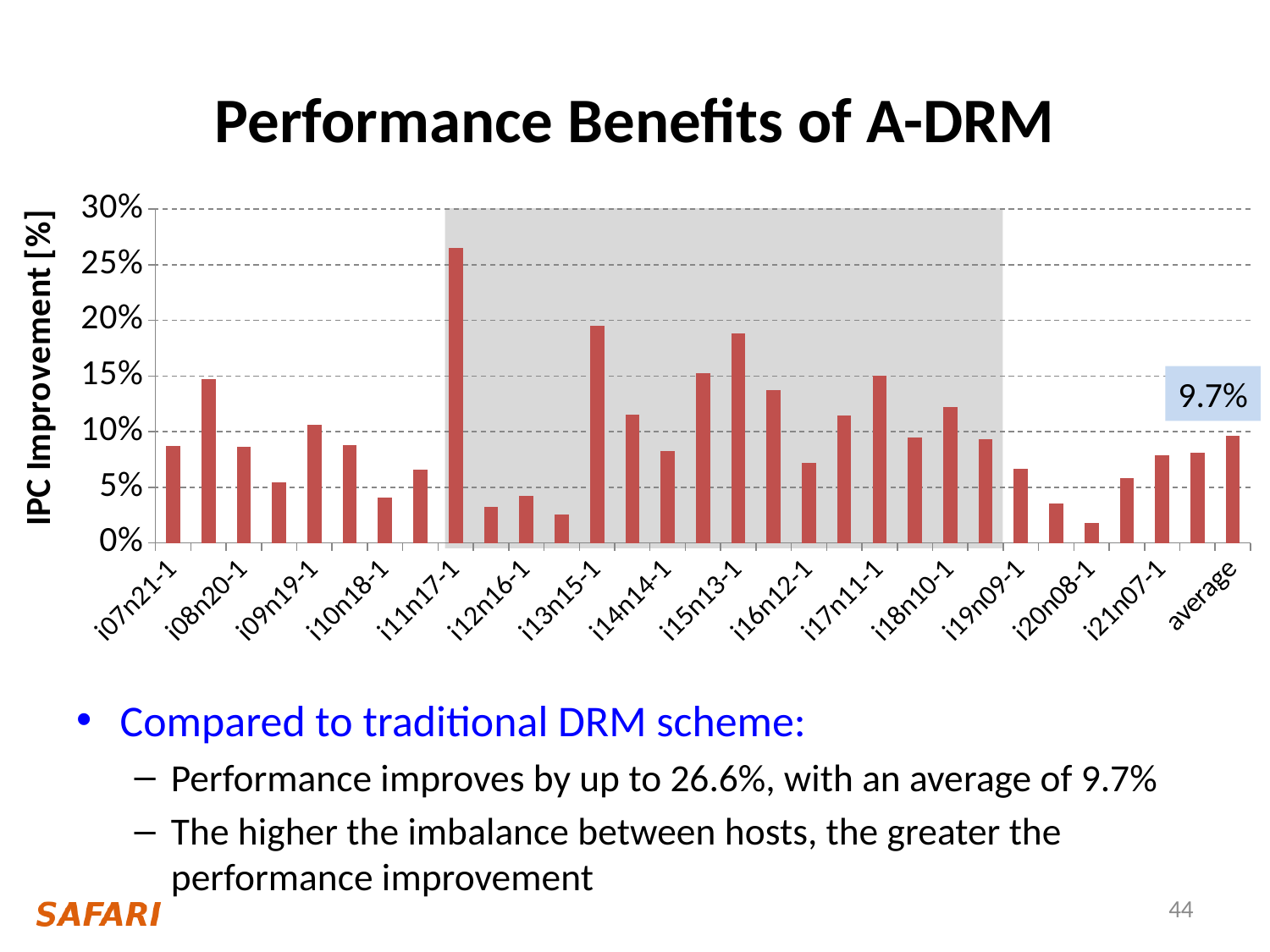
Which category has the highest IPC improvement? i11n17-1 What is the IPC improvement value shown for the 'average' bar? 9.7% What is the label of the y-axis? IPC Improvement [%] Which has a higher IPC improvement, i13n15-1 or i14n14-1? i13n15-1 Is the value for i13n15-1 greater or less than 15%? greater Is the value for i20n08-1 greater or less than 5%? less Is the value for i08n20-1 greater or less than 10%? less What type of chart is shown on the slide? bar chart What is the highest value shown on the y-axis? 30%